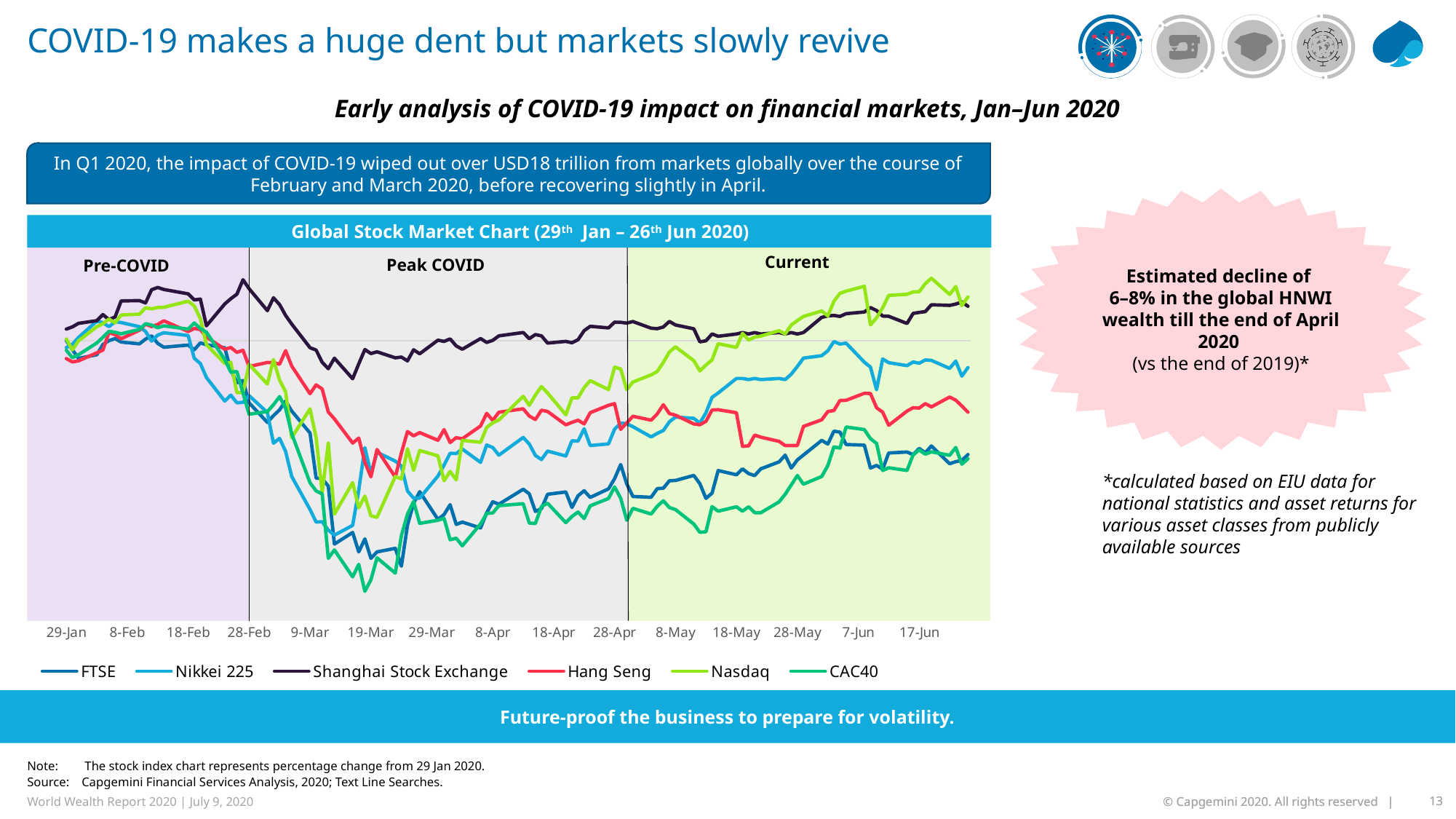
At the right-hand end of the Global Stock Market Chart, which is higher: Shanghai Stock Exchange or CAC40? Shanghai Stock Exchange What kind of chart is the Global Stock Market Chart? line chart At the right-hand end of the Global Stock Market Chart, which is higher: Nasdaq or Hang Seng? Nasdaq What are the three period labels shown across the top of the Global Stock Market Chart? Pre-COVID, Peak COVID, Current Which series is the highest at the right-hand end of the Global Stock Market Chart (late June)? Nasdaq Around 19-Mar on the Global Stock Market Chart, which series is higher: Shanghai Stock Exchange or Nikkei 225? Shanghai Stock Exchange What date range is given in the title of the Global Stock Market Chart? 29th Jan – 26th Jun 2020 How many series does the legend of the Global Stock Market Chart list? 6 Do the index lines on the Global Stock Market Chart generally rise or fall between 28-Feb and 19-Mar? fall Does the Nasdaq line on the Global Stock Market Chart rise or fall between 28-Apr and 17-Jun? rise How many date labels are shown on the x axis of the Global Stock Market Chart? 15 Which series reaches the lowest point on the Global Stock Market Chart during the Peak COVID period (around 19-Mar)? CAC40